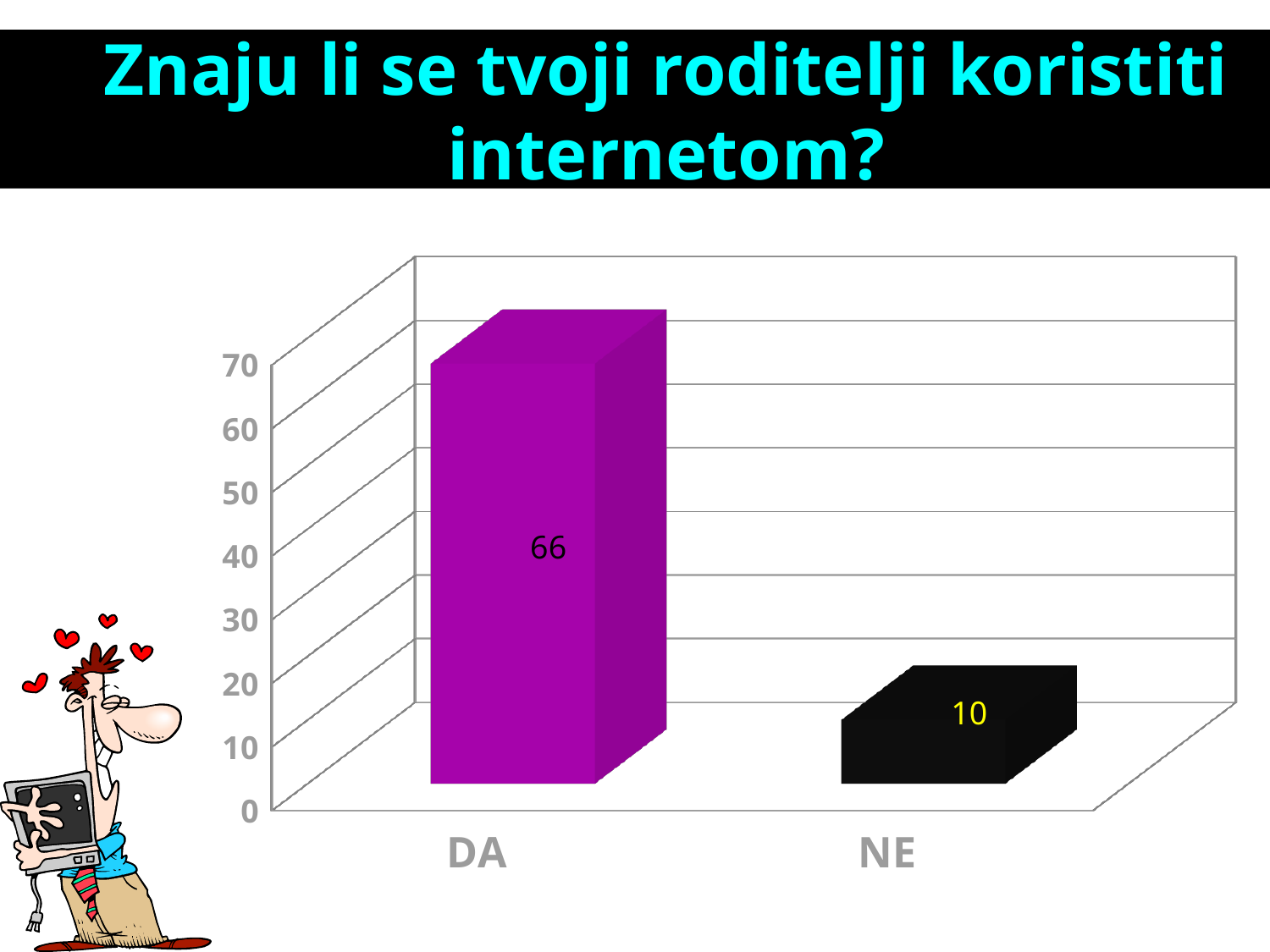
Is the value for NE greater or less than 20? less How many categories are shown on the x axis? 2 What is the value for NE? 10 Which is larger, the value for DA or the value for NE? DA Which category has the highest value? DA What colour is the bar for DA? purple What kind of chart is shown on the slide? bar chart Is the value for DA greater or less than 50? greater What is the value for DA? 66 What is the title of the slide above the chart? Znaju li se tvoji roditelji koristiti internetom? Which category has the lowest value? NE What is the difference between the values for DA and NE? 56